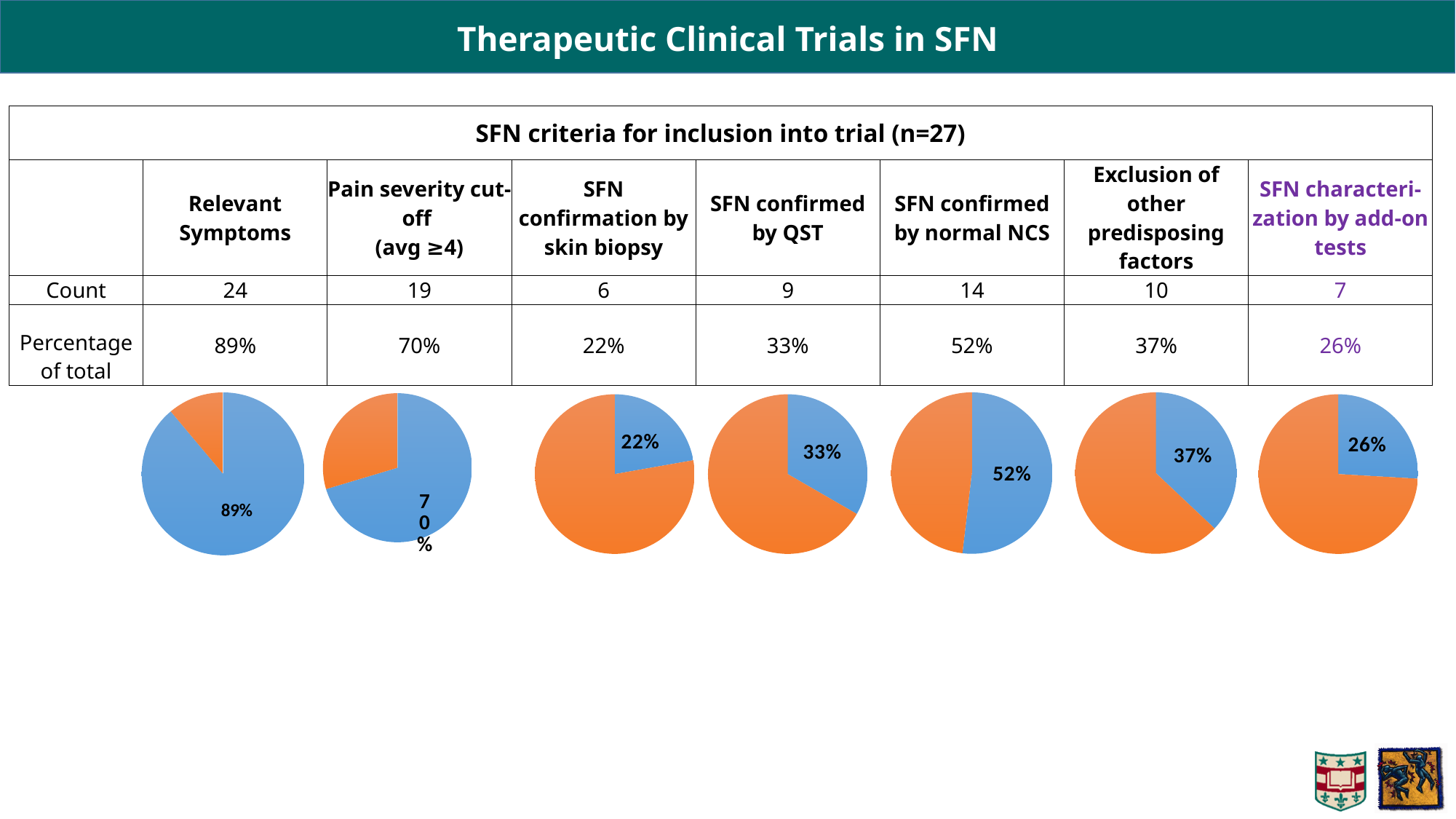
What two colours are used for the slices in the pie charts? Blue and orange What is the difference between the blue slice percentages in the first pie chart (89%) and the second pie chart (70%)? 19% Which pie chart has the smallest labelled blue slice? The third one (SFN confirmation by skin biopsy), 22% In the fifth pie chart (SFN confirmed by normal NCS), is the blue slice greater or less than 50%? greater In the third pie chart from the left (under SFN confirmation by skin biopsy), what percentage is labelled on the blue slice? 22% In the last pie chart on the right (under SFN characterization by add-on tests), what percentage is labelled on the blue slice? 26% In the fifth pie chart from the left (under SFN confirmed by normal NCS), what percentage is labelled on the blue slice? 52% What kind of charts are shown below the table on the slide? Pie charts How many pie charts are shown on the slide? 7 Which pie chart has the largest labelled blue slice? The first one (Relevant Symptoms), 89% Is the blue slice in the fourth pie chart (SFN confirmed by QST) larger or smaller than the blue slice in the sixth pie chart (Exclusion of other predisposing factors)? Smaller In the first pie chart from the left (under Relevant Symptoms), what percentage is labelled on the blue slice? 89%